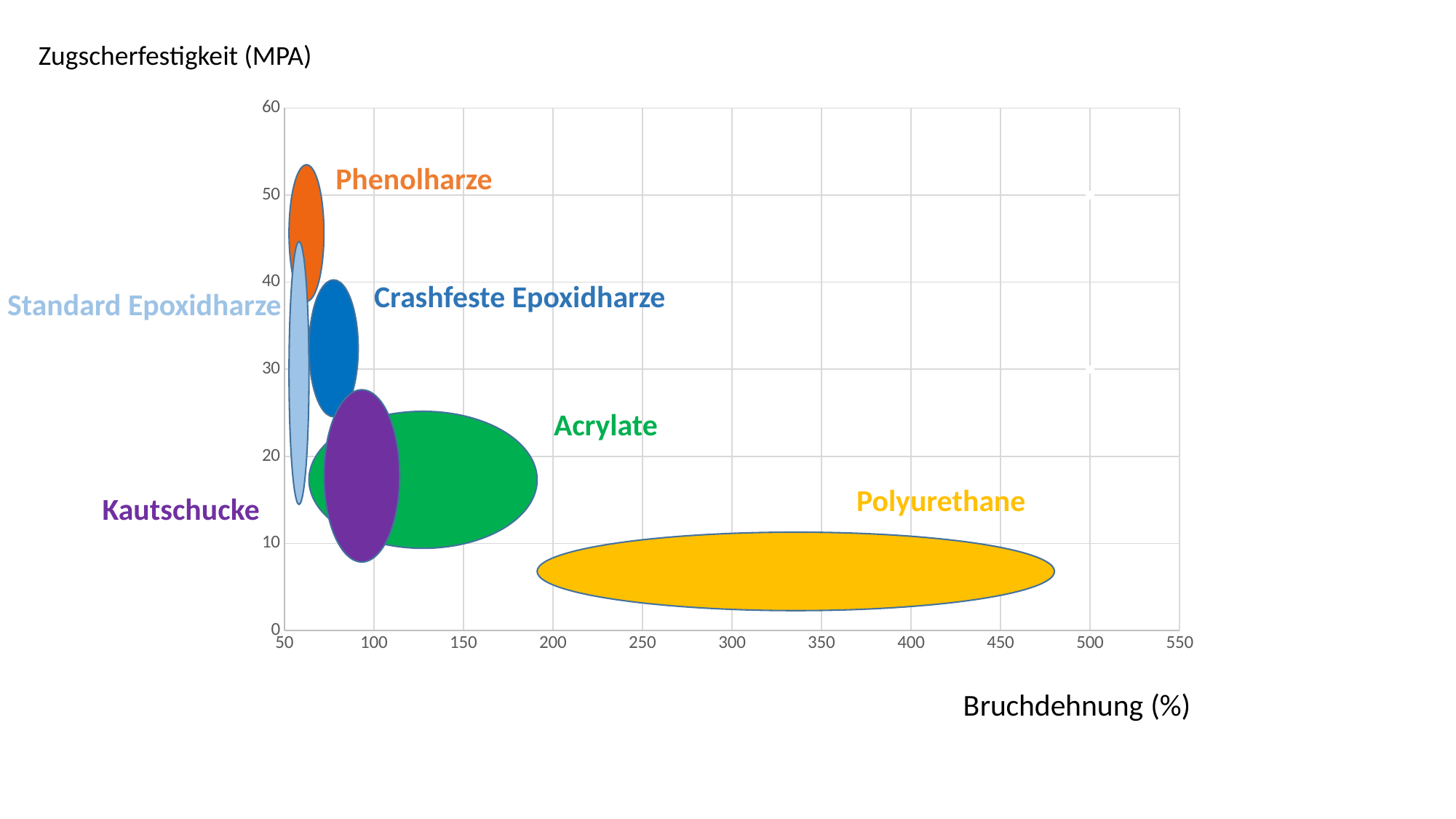
Is the Zugscherfestigkeit of Phenolharze greater or less than 30 MPA? greater What is the label of the horizontal axis? Bruchdehnung (%) Is the Bruchdehnung of Acrylate greater or less than 250%? less Which has the higher Zugscherfestigkeit, Crashfeste Epoxidharze or Kautschucke? Crashfeste Epoxidharze Is the Zugscherfestigkeit of Polyurethane greater or less than 20 MPA? less What colour is the Polyurethane region on the chart? Yellow Which material group reaches the highest Zugscherfestigkeit on the chart? Phenolharze Which material group has the lowest Zugscherfestigkeit on the chart? Polyurethane Which material group reaches the highest Bruchdehnung on the chart? Polyurethane What kind of chart is shown on the slide? Bubble chart Which has the greater Bruchdehnung, Acrylate or Polyurethane? Polyurethane How many material groups are plotted on the chart? 6